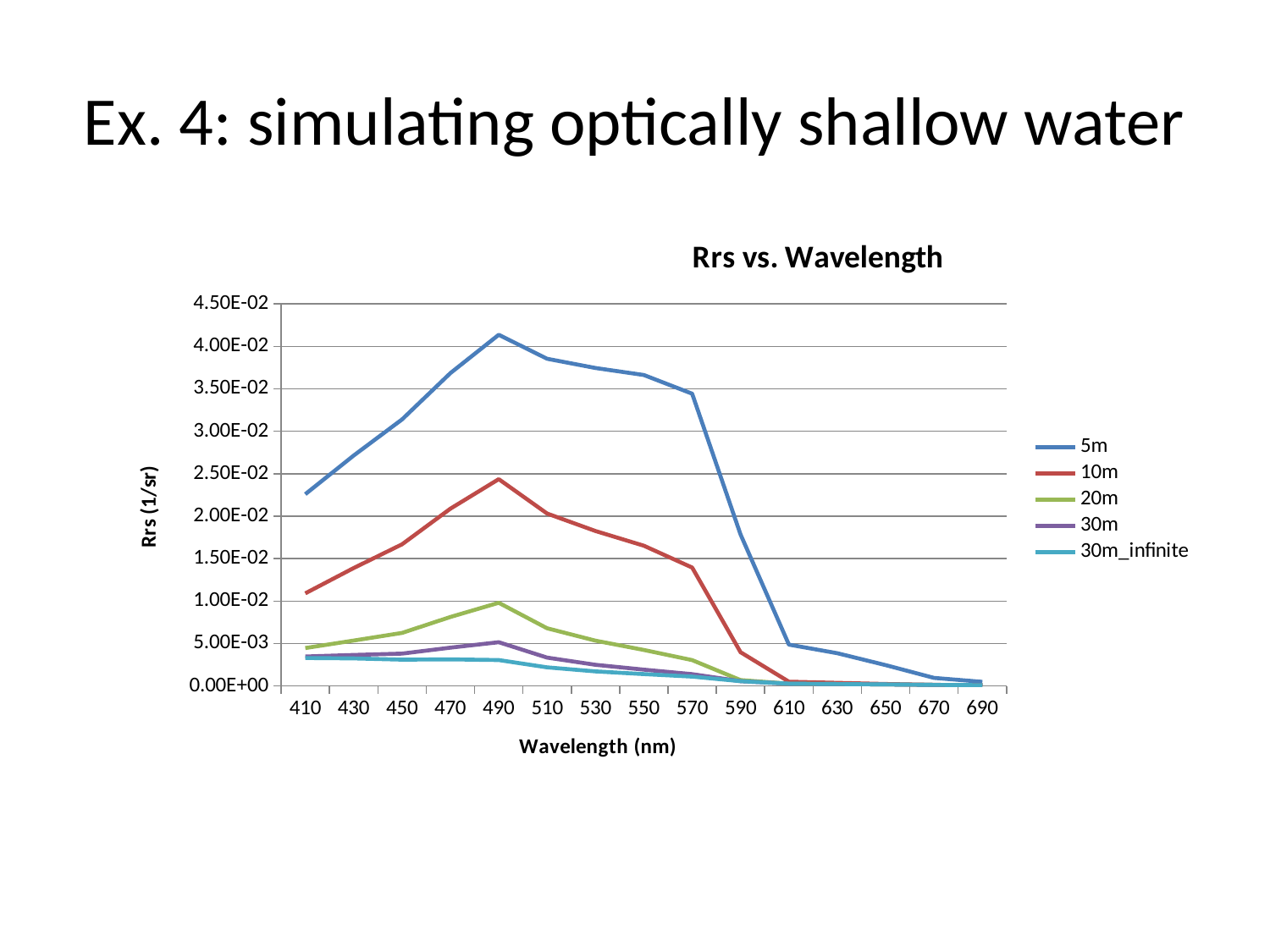
At which wavelength does the 5m series reach its peak? 490 Is the value for the 5m series at 610 nm greater or less than 1.00E-02? less How many wavelength points are labelled along the x axis? 15 What kind of chart is shown on the slide? line chart Is the value for the 5m series at 490 nm greater or less than 4.00E-02? greater Which series has the lowest Rrs values across the wavelengths? 30m_infinite How many series does the legend list? 5 Which series has the highest Rrs value at 490 nm? 5m What is the title of the chart? Rrs vs. Wavelength Does the 5m series rise or fall between 490 nm and 690 nm? fall Is the value for the 10m series at 490 nm greater or less than 2.00E-02? greater What is the label of the y axis? Rrs (1/sr)